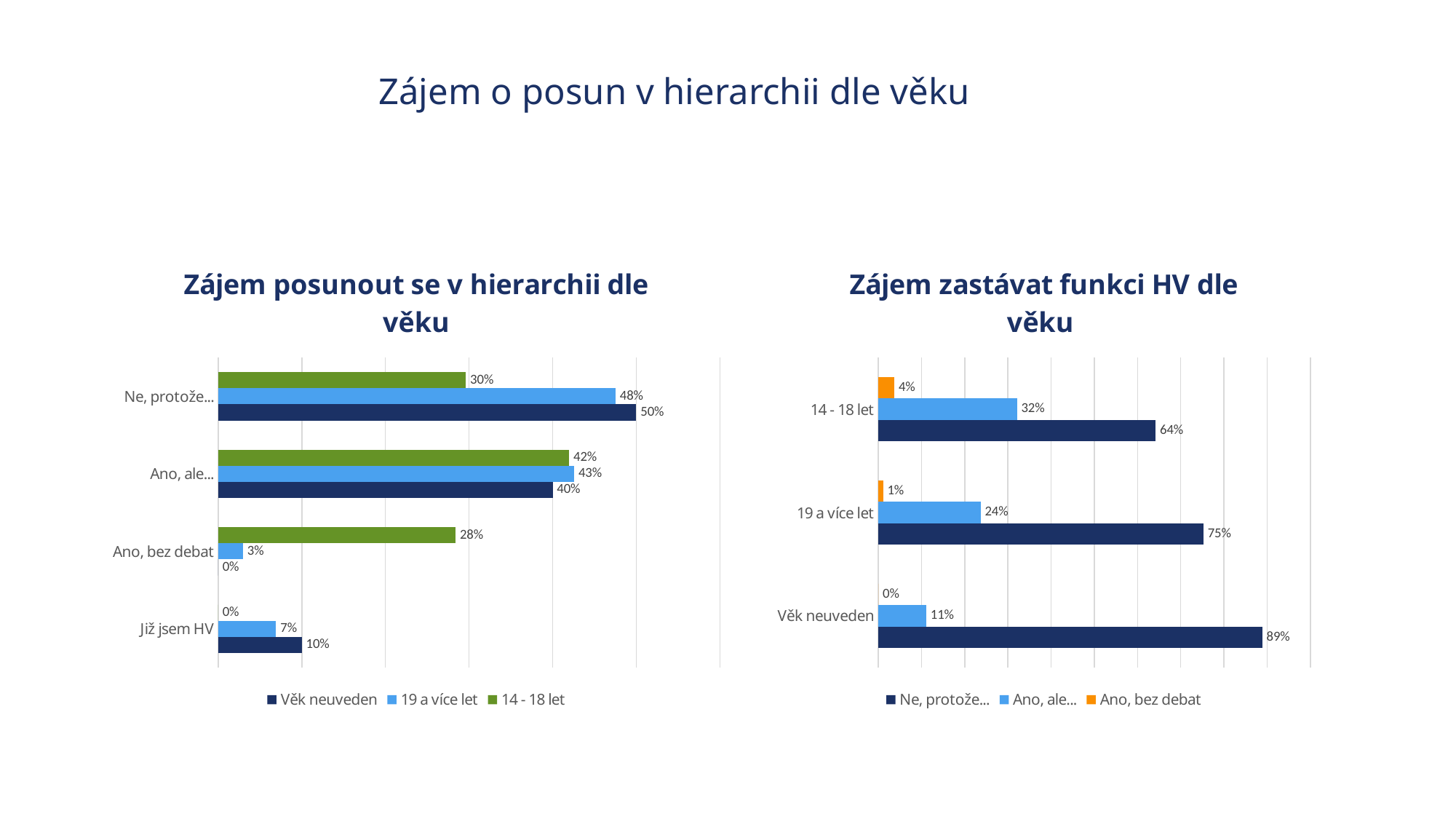
In the chart 'Zájem zastávat funkci HV dle věku', what is the value for 'Ne, protože…' in the category 'Věk neuveden'? 89% In the chart 'Zájem posunout se v hierarchii dle věku', how many categories are shown on the vertical axis? 4 In the chart 'Zájem posunout se v hierarchii dle věku', what is the difference between the '19 a více let' and '14 - 18 let' values in the category 'Ne, protože…'? 18% In the chart 'Zájem zastávat funkci HV dle věku', which category has the highest value for 'Ne, protože…'? Věk neuveden In the chart 'Zájem posunout se v hierarchii dle věku', what is the value for 'Věk neuveden' in the category 'Ne, protože…'? 50% In the chart 'Zájem zastávat funkci HV dle věku', which category has the lowest value for 'Ano, bez debat'? Věk neuveden In the chart 'Zájem zastávat funkci HV dle věku', what is the value for 'Ano, ale…' in the category '14 - 18 let'? 32% What type of chart is 'Zájem zastávat funkci HV dle věku'? Bar chart In the chart 'Zájem posunout se v hierarchii dle věku', what is the value for '19 a více let' in the category 'Již jsem HV'? 7% In the chart 'Zájem zastávat funkci HV dle věku', which is larger: the 'Ano, ale…' value for '14 - 18 let' or for '19 a více let'? 14 - 18 let In the chart 'Zájem posunout se v hierarchii dle věku', how many series does the legend list? 3 In the chart 'Zájem posunout se v hierarchii dle věku', what is the value for '14 - 18 let' in the category 'Ano, bez debat'? 28%